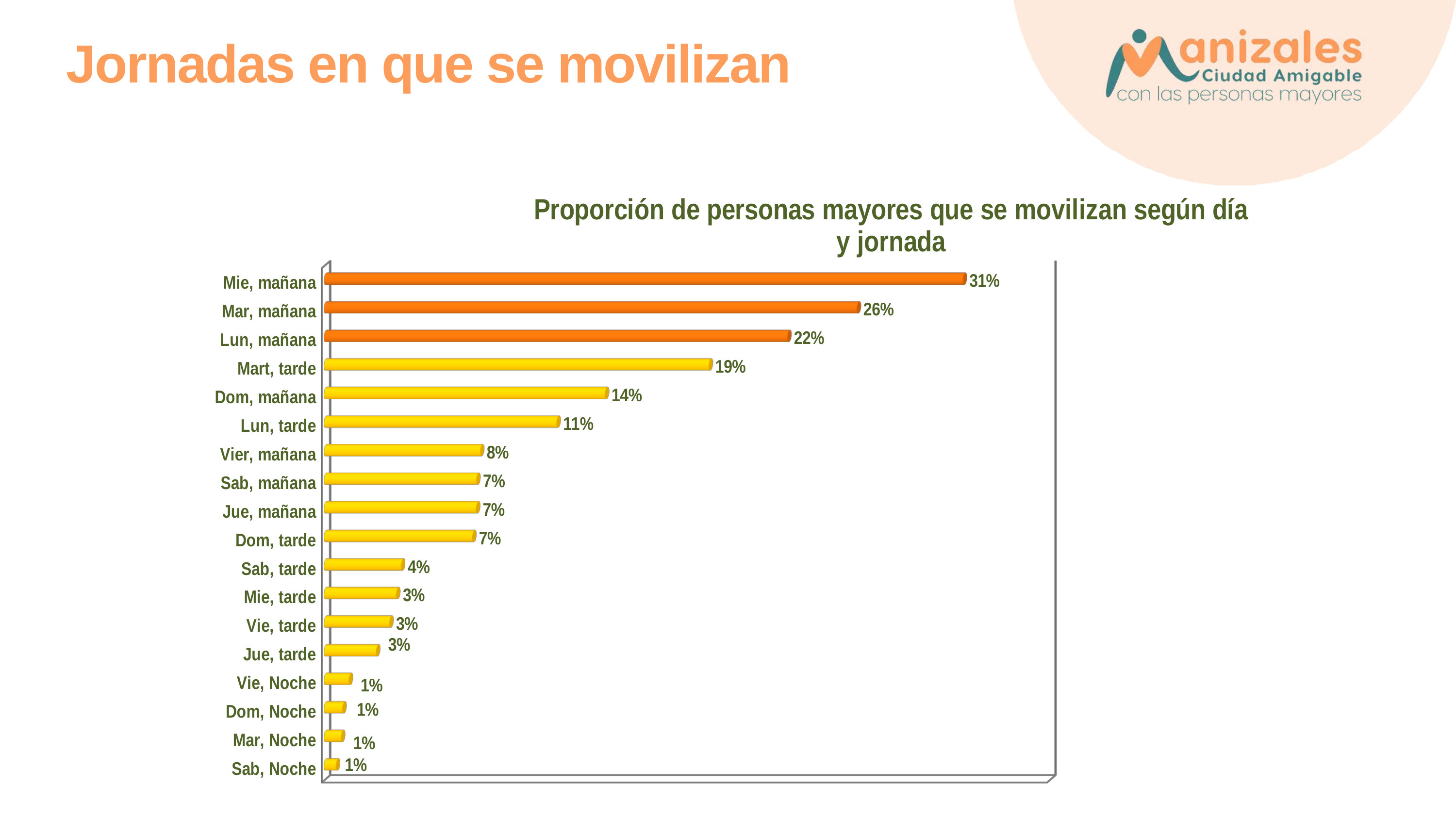
Which is larger, the value for Lun, mañana or the value for Mart, tarde? Lun, mañana What kind of chart is shown on the slide? Bar chart Which category has the highest value? Mie, mañana What is the difference between the values for Mart, tarde and Lun, tarde? 8% What is the value for Lun, tarde? 11% What is the difference between the values for Mie, mañana and Mar, mañana? 5% What is the value for Sab, tarde? 4% What is the value for Mie, mañana? 31% What is the value for Dom, mañana? 14% What is the title of the chart? Proporción de personas mayores que se movilizan según día y jornada Which is larger, the value for Vier, mañana or the value for Sab, tarde? Vier, mañana How many categories are shown in the chart? 18